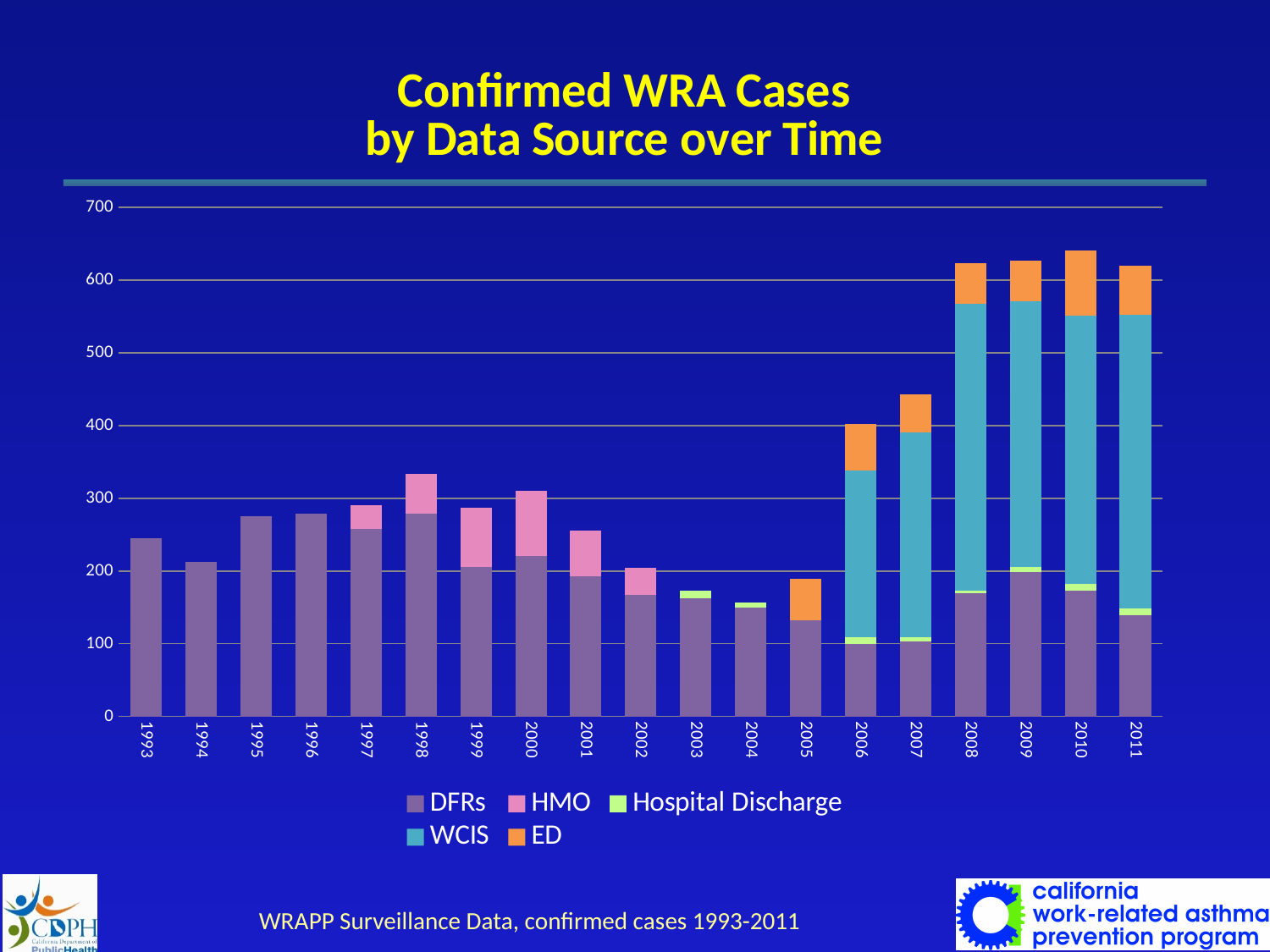
Which year has the shortest total bar? 2004 Which data source in the legend is shown in orange? ED Is the total bar for 2007 greater or less than 400? greater Is the total bar for 1993 greater or less than 300? less What kind of chart is shown on the slide? Stacked bar chart Which year has the tallest total bar? 2010 How many years are shown along the x axis of the chart? 19 Which year has the taller total bar, 1994 or 1995? 1995 Is the total bar for 2008 greater or less than 600? greater How many data sources does the legend list? 5 Do the total bars rise or fall from 2005 to 2010? rise